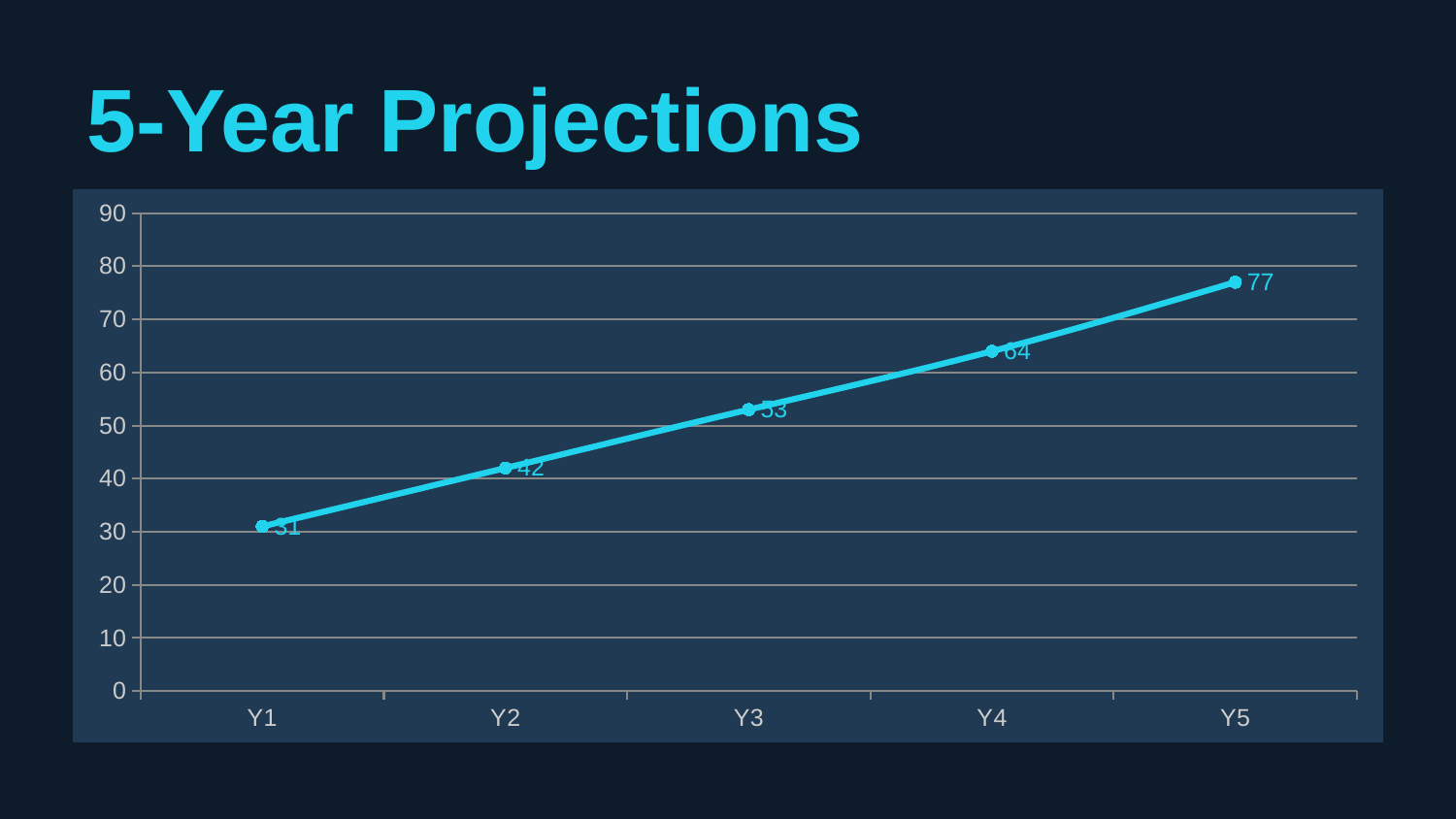
What kind of chart is shown on the slide? line chart How many years are plotted on the x axis? 5 Which year has the highest value? Y5 What is the value for Y3? 53 What is the value for Y5? 77 Which year has the lowest value? Y1 What is the value for Y1? 31 What is the difference between the values for Y5 and Y1? 46 Is the value for Y4 greater or less than 60? greater Which is larger, the value for Y2 or the value for Y4? Y4 Do the values rise or fall from Y1 to Y5? rise What is the difference between the values for Y4 and Y2? 22